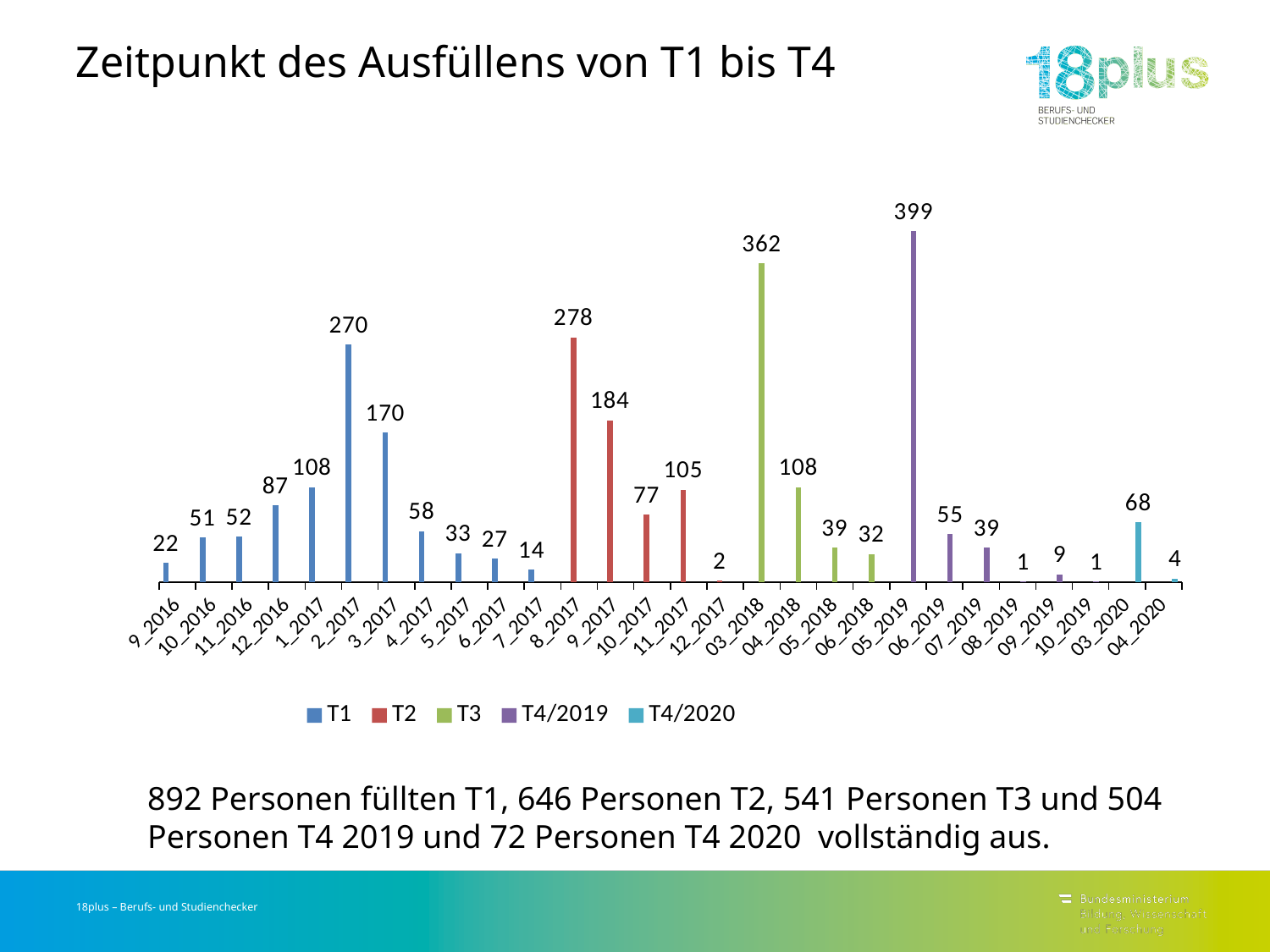
What is the title of the chart? Zeitpunkt des Ausfüllens von T1 bis T4 What is the value for 04_2020? 4 What kind of chart is shown? bar chart How many series does the legend list? 5 How many categories are shown on the x axis? 28 Which category has the lowest value among the T1 bars? 7_2017 What is the difference between the values for 03_2018 and 8_2017? 84 What is the value for 2_2017? 270 Do the T1 values rise or fall from 2_2017 to 7_2017? fall Which category has the highest value? 05_2019 Which is larger, the value for 3_2017 or the value for 9_2017? 9_2017 What is the value for 8_2017? 278